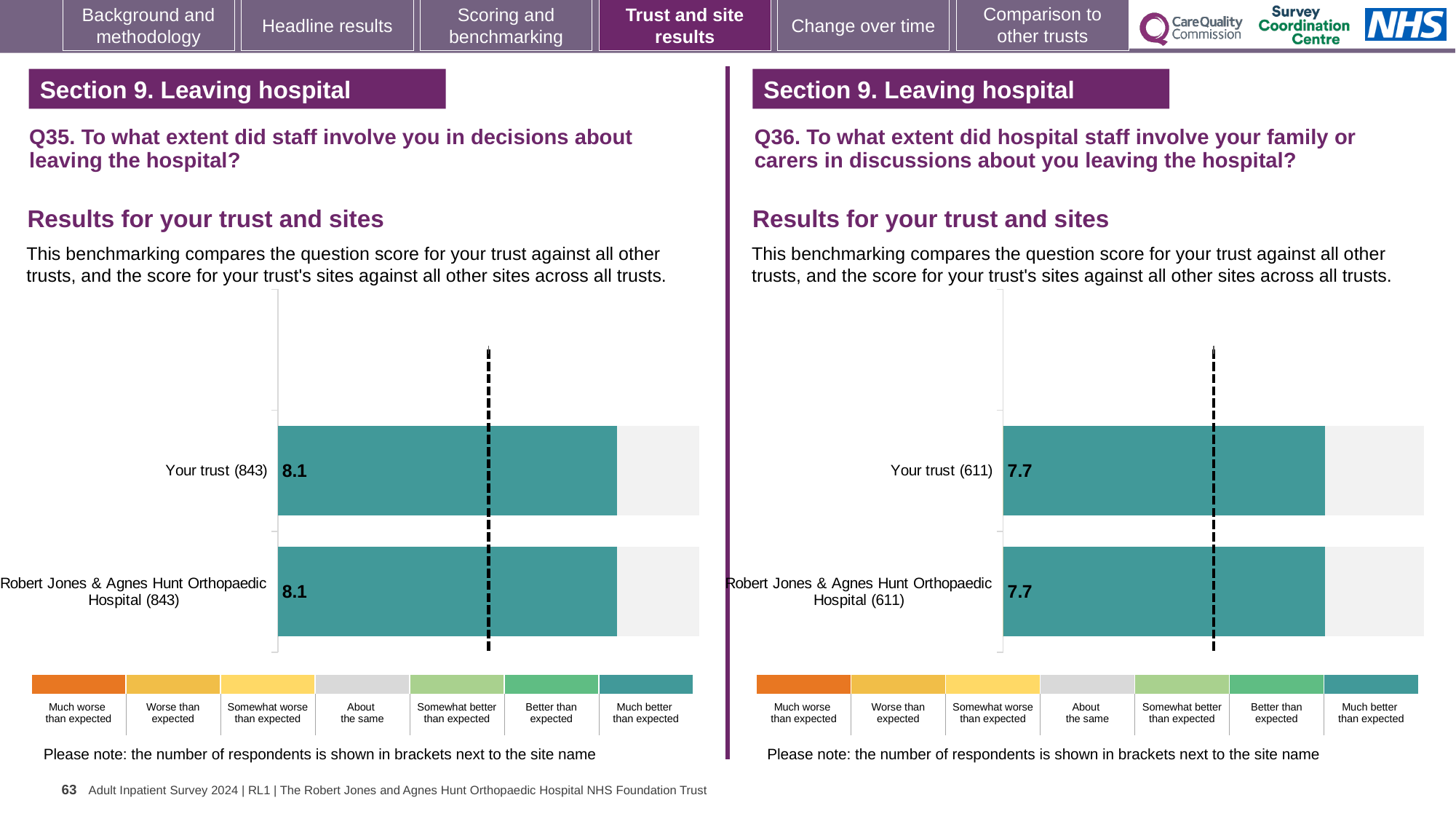
What kind of chart is used for the Q36 results on the right? Bar chart How many benchmark categories does the colour key below the Q35 chart on the left list? 7 How many bars are plotted in the Q36 chart on the right? 2 How many bars are plotted in the Q35 chart on the left? 2 In the Q35 chart on the left, what is the score for Robert Jones & Agnes Hunt Orthopaedic Hospital? 8.1 In the Q35 chart on the left, what is the difference between the score for Your trust and the score for Robert Jones & Agnes Hunt Orthopaedic Hospital? 0 In the Q36 chart on the right, what is the score for Robert Jones & Agnes Hunt Orthopaedic Hospital? 7.7 How many respondents are shown in brackets for Your trust in the Q36 chart on the right? 611 In the Q36 chart on the right, what is the difference between the score for Your trust and the score for Robert Jones & Agnes Hunt Orthopaedic Hospital? 0 How many respondents are shown in brackets for Your trust in the Q35 chart on the left? 843 In the Q36 chart on the right, what is the score for Your trust? 7.7 In the Q35 chart on the left, what is the score for Your trust? 8.1